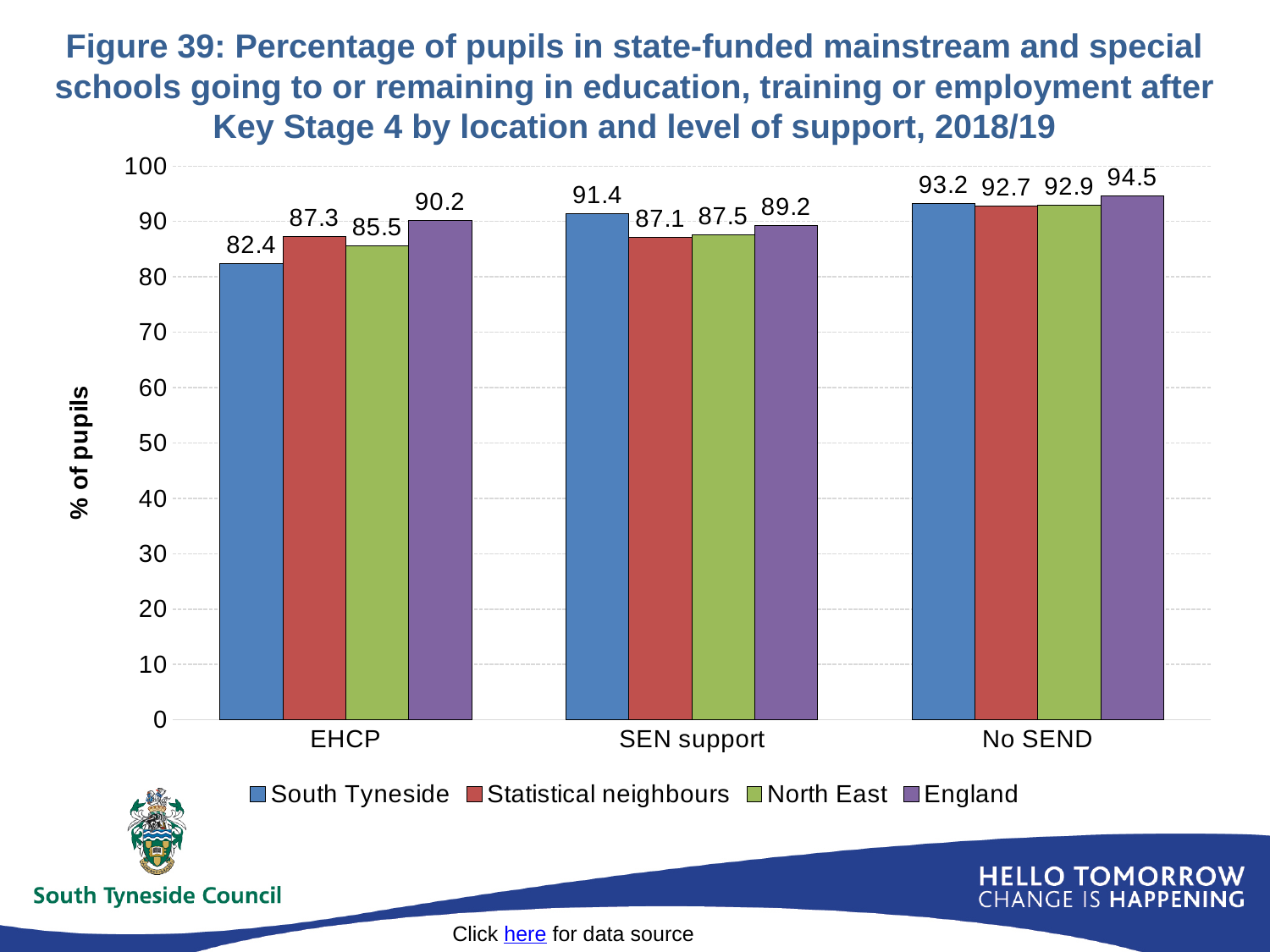
Do the South Tyneside values rise or fall from EHCP to No SEND? Rise What kind of chart is shown on the slide? Bar chart Which is larger in the SEN support category: South Tyneside or England? South Tyneside What is the value for England in the SEN support category? 89.2 How many categories are shown on the x axis? 3 What is the value for South Tyneside in the EHCP category? 82.4 What is the label of the y axis? % of pupils Which series has the lowest value in the SEN support category? Statistical neighbours Which series has the highest value in the EHCP category? England What is the difference between the England and South Tyneside values in the EHCP category? 7.8 How many series does the legend list? 4 What is the value for North East in the No SEND category? 92.9